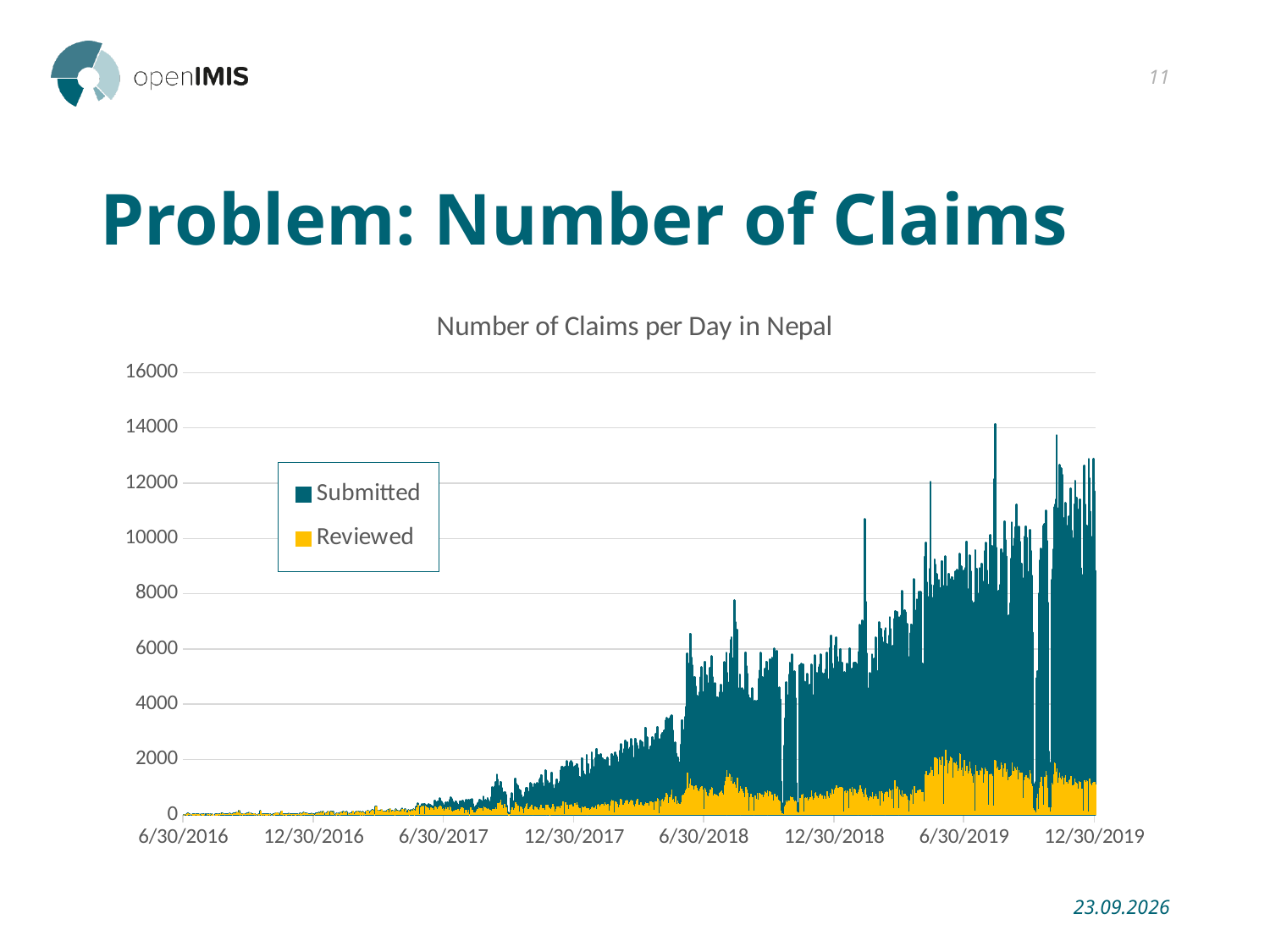
What is the title of the chart? Number of Claims per Day in Nepal Is the Submitted value on 6/30/2016 greater or less than 2000? less Which series generally has the larger daily values, Submitted or Reviewed? Submitted Do the Submitted claims per day generally rise or fall from 6/30/2016 to 12/30/2019? Rise What is the maximum value shown on the vertical axis? 16000 How many series does the chart legend list? 2 What kind of chart is shown on the slide? Bar chart Is the highest daily Submitted value on the chart greater or less than 12000? greater Is the highest daily Reviewed value on the chart greater or less than 4000? less What are the two series named in the legend? Submitted and Reviewed